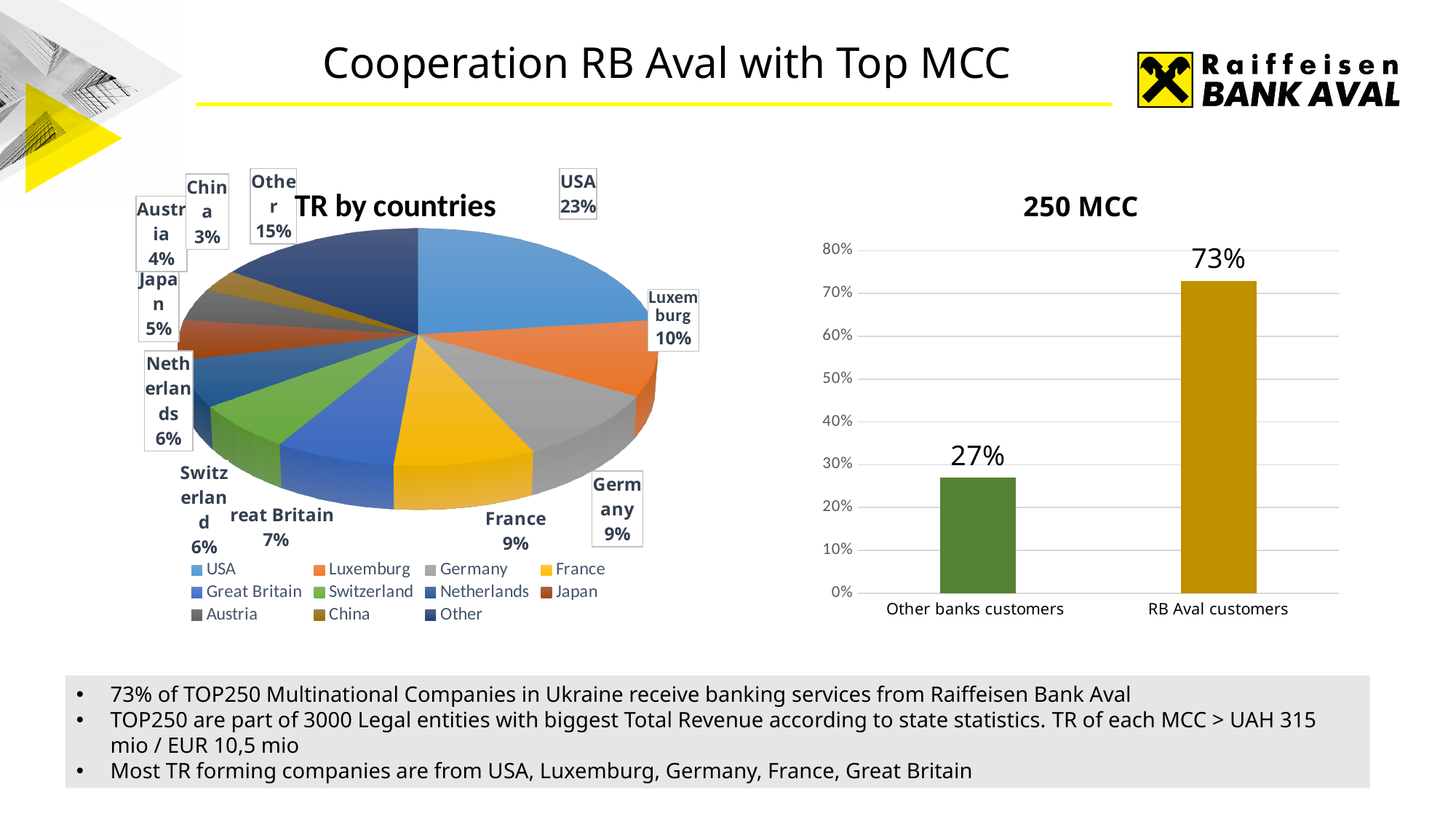
In the "TR by countries" pie chart, how many slices are there? 11 In the "TR by countries" pie chart, what share does Luxemburg have? 10% What kind of chart is the "250 MCC" chart? Bar chart In the "250 MCC" chart, what is the value for RB Aval customers? 73% In the "250 MCC" chart, what is the difference between RB Aval customers and Other banks customers? 46% In the "250 MCC" chart, what is the value for Other banks customers? 27% In the "TR by countries" pie chart, what is the difference between the USA share and the Luxemburg share? 13% In the "TR by countries" pie chart, which country has the smallest share? China In the "TR by countries" pie chart, what share does USA have? 23% In the "TR by countries" pie chart, which is larger, Great Britain or Austria? Great Britain In the "TR by countries" pie chart, what share does Japan have? 5% In the "TR by countries" pie chart, which named country has the largest share? USA